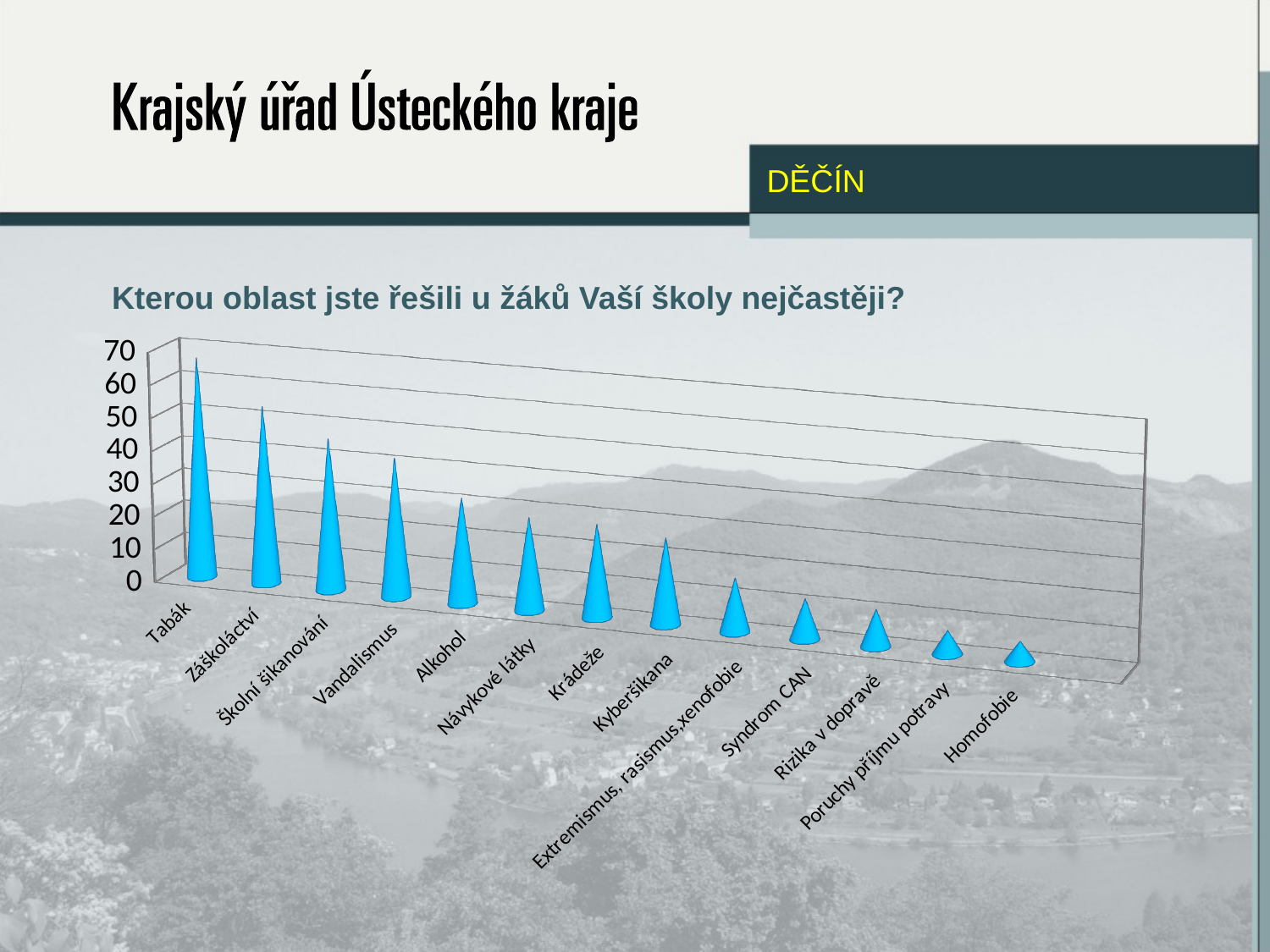
Is the value for Záškoláctví greater or less than 40? greater Is the value for Homofobie greater or less than 10? less What is the title of the chart? Kterou oblast jste řešili u žáků Vaší školy nejčastěji? Which is larger, the value for Tabák or the value for Alkohol? Tabák What kind of chart is shown on the slide? bar chart Which is larger, the value for Syndrom CAN or the value for Vandalismus? Vandalismus Which category has the lowest value? Homofobie Which category has the highest value? Tabák Do the values rise or fall from left to right along the x axis? fall How many categories are plotted on the chart? 13 Is the value for Tabák greater or less than 50? greater